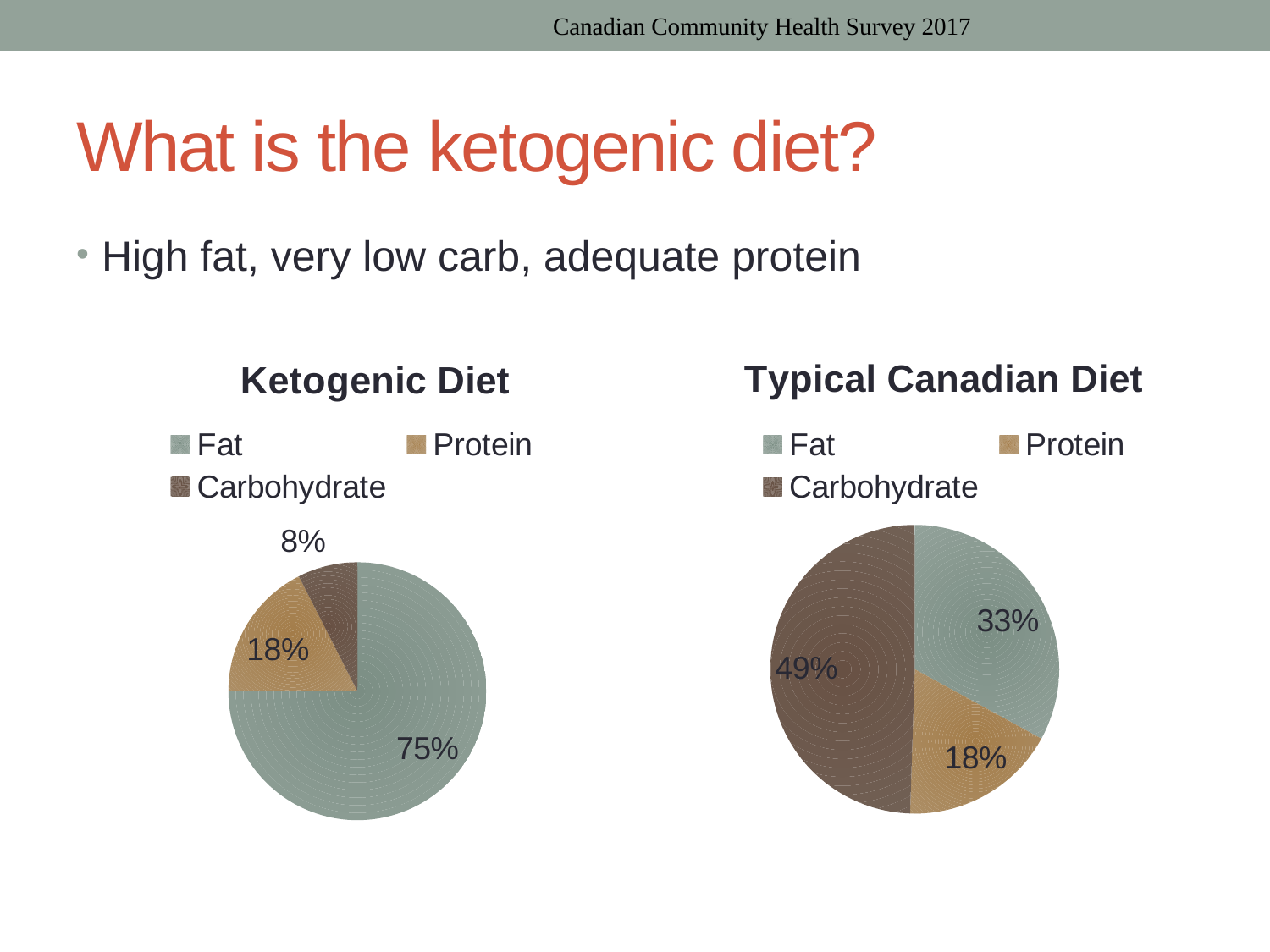
In the Typical Canadian Diet chart, is the share for Fat or Carbohydrate larger? Carbohydrate In the Typical Canadian Diet chart, which category has the smallest share? Protein In the Ketogenic Diet chart, which category has the largest share? Fat How many categories does the Ketogenic Diet chart show? 3 In the Typical Canadian Diet chart, what percentage is Carbohydrate? 49% What is the difference between the Fat share in the Ketogenic Diet chart and the Fat share in the Typical Canadian Diet chart? 42% In the Ketogenic Diet chart, what percentage is Fat? 75% In the Ketogenic Diet chart, which category has the smallest share? Carbohydrate What type of chart is the Typical Canadian Diet chart? Pie chart In the Typical Canadian Diet chart, what percentage is Fat? 33% In the Ketogenic Diet chart, what percentage is Carbohydrate? 8% In the Typical Canadian Diet chart, which category has the largest share? Carbohydrate